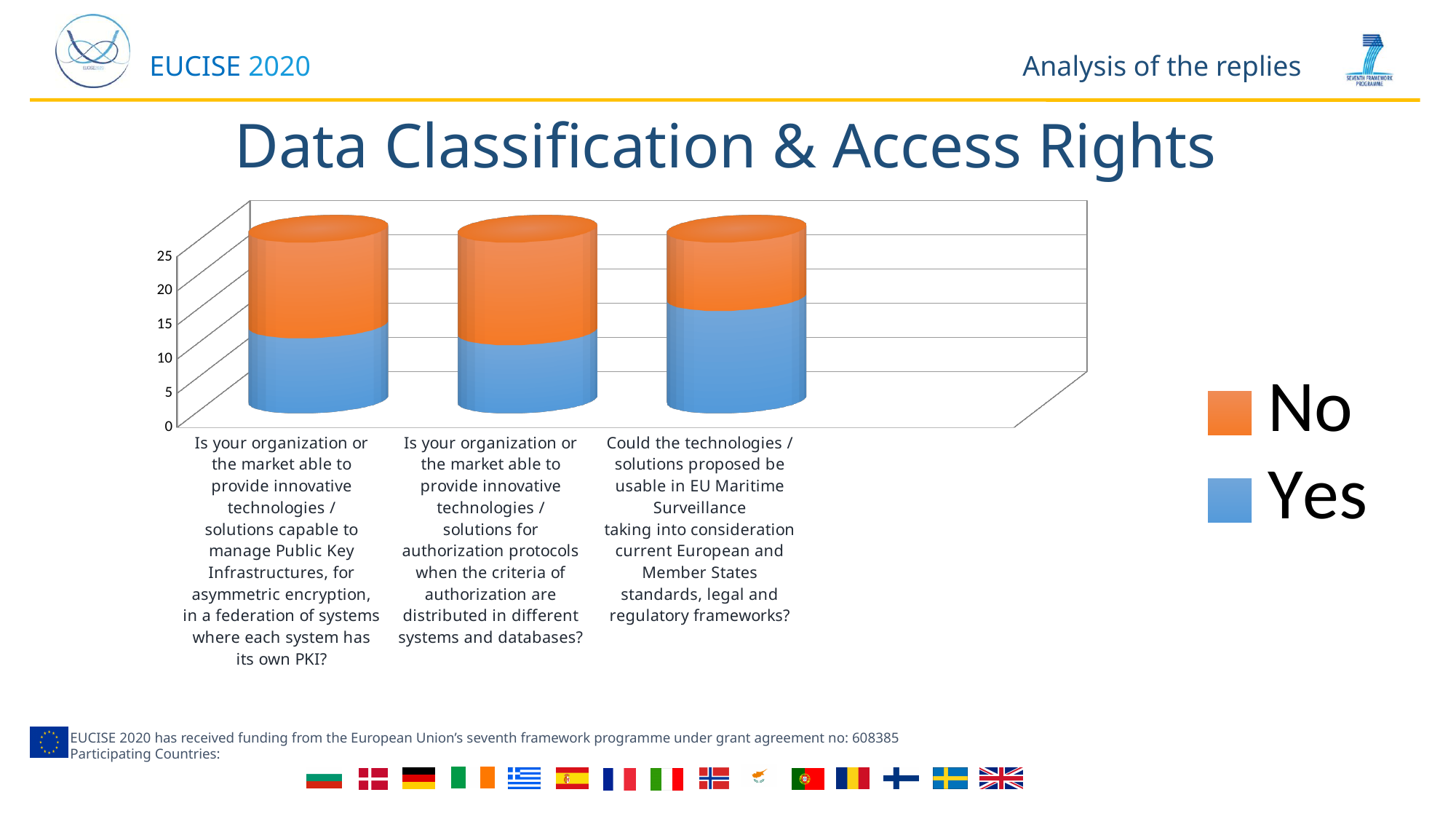
Is the number of Yes replies for the question about authorization protocols greater or less than 15? less Which has more Yes replies: the question about Public Key Infrastructures or the question about usability in EU Maritime Surveillance? the question about usability in EU Maritime Surveillance How many series does the legend list? 2 Which question received the lowest number of No replies? Could the technologies / solutions proposed be usable in EU Maritime Surveillance taking into consideration current European and Member States standards, legal and regulatory frameworks? What is the title of the chart slide? Data Classification & Access Rights Which question received the highest number of Yes replies? Could the technologies / solutions proposed be usable in EU Maritime Surveillance taking into consideration current European and Member States standards, legal and regulatory frameworks? How many survey questions (categories) are plotted in the chart? 3 Is the number of Yes replies for the question about usability in EU Maritime Surveillance greater or less than 10? greater Which series is shown in orange in the legend? No Is the number of Yes replies for the question about Public Key Infrastructures greater or less than 15? less What kind of chart is shown on the slide? bar chart